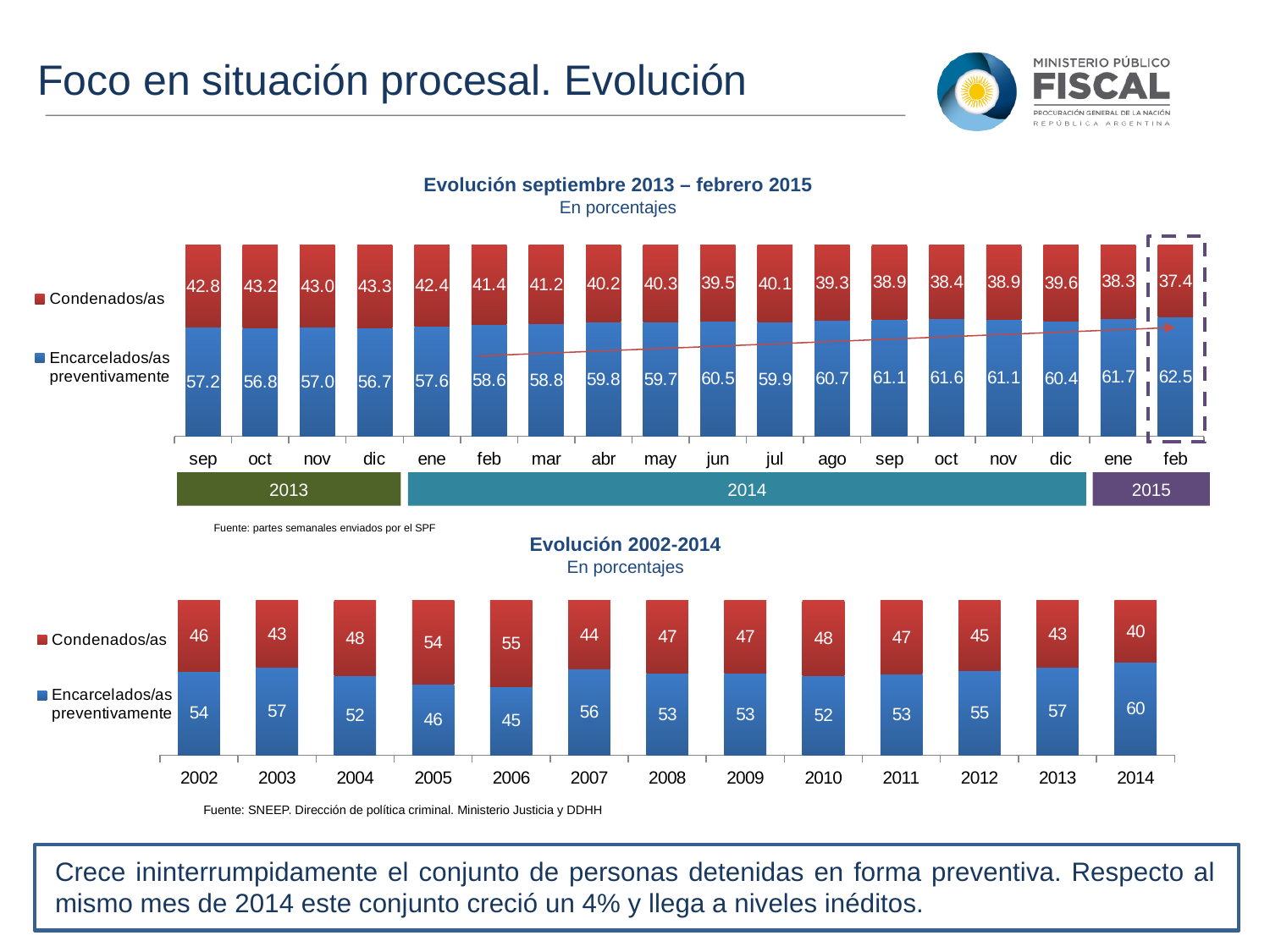
In the bottom chart (Evolución 2002-2014), which series has the larger value in 2005, Condenados/as or Encarcelados/as preventivamente? Condenados/as How many series does the legend of the top chart (Evolución septiembre 2013 – febrero 2015) list? 2 In the bottom chart (Evolución 2002-2014), what is the total of the stacked bar for 2002? 100 In the bottom chart (Evolución 2002-2014), which year has the highest value for Encarcelados/as preventivamente? 2014 In the top chart (Evolución septiembre 2013 – febrero 2015), do the Condenados/as values generally rise or fall from sep 2013 to feb 2015? Fall What kind of chart is the bottom chart (Evolución 2002-2014)? Stacked bar chart In the top chart (Evolución septiembre 2013 – febrero 2015), which month has the lowest value for Condenados/as? feb 2015 In the bottom chart (Evolución 2002-2014), which year has the lowest value for Encarcelados/as preventivamente? 2006 In the top chart (Evolución septiembre 2013 – febrero 2015), what is the value for Encarcelados/as preventivamente in feb 2015? 62.5 How many years are shown on the x axis of the bottom chart (Evolución 2002-2014)? 13 In the bottom chart (Evolución 2002-2014), what is the value for Condenados/as in 2006? 55 In the top chart (Evolución septiembre 2013 – febrero 2015), what is the difference between the Encarcelados/as preventivamente value in feb 2015 and in sep 2013? 5.3